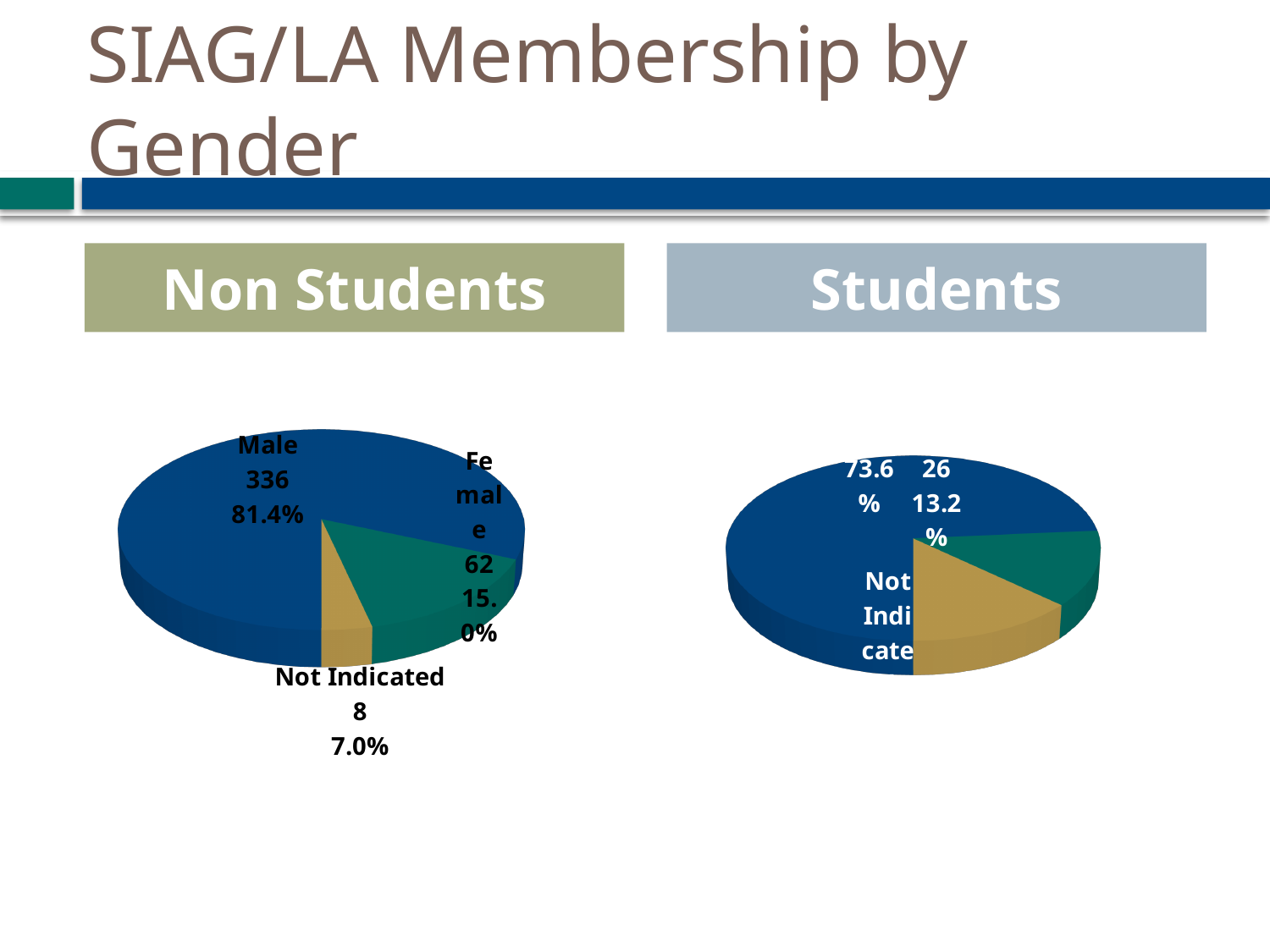
In the Non Students chart, what share of the pie is Male? 81.4% In the Non Students chart, what percentage of members are Female? 15.0% In the Non Students chart, how many members are in the Not Indicated category? 8 How many slices does the Non Students pie chart have? 3 In the Non Students chart, which category has the largest slice? Male In the Non Students chart, which category has the smallest slice? Not Indicated In the Non Students chart, how many members are Male? 336 In the Non Students chart, which has more members, Female or Not Indicated? Female What kind of chart is the Non Students chart? pie chart In the Non Students chart, what colour is the Male slice? blue How many slices does the Students pie chart have? 3 In the Non Students chart, how many more members are Male than Female? 274